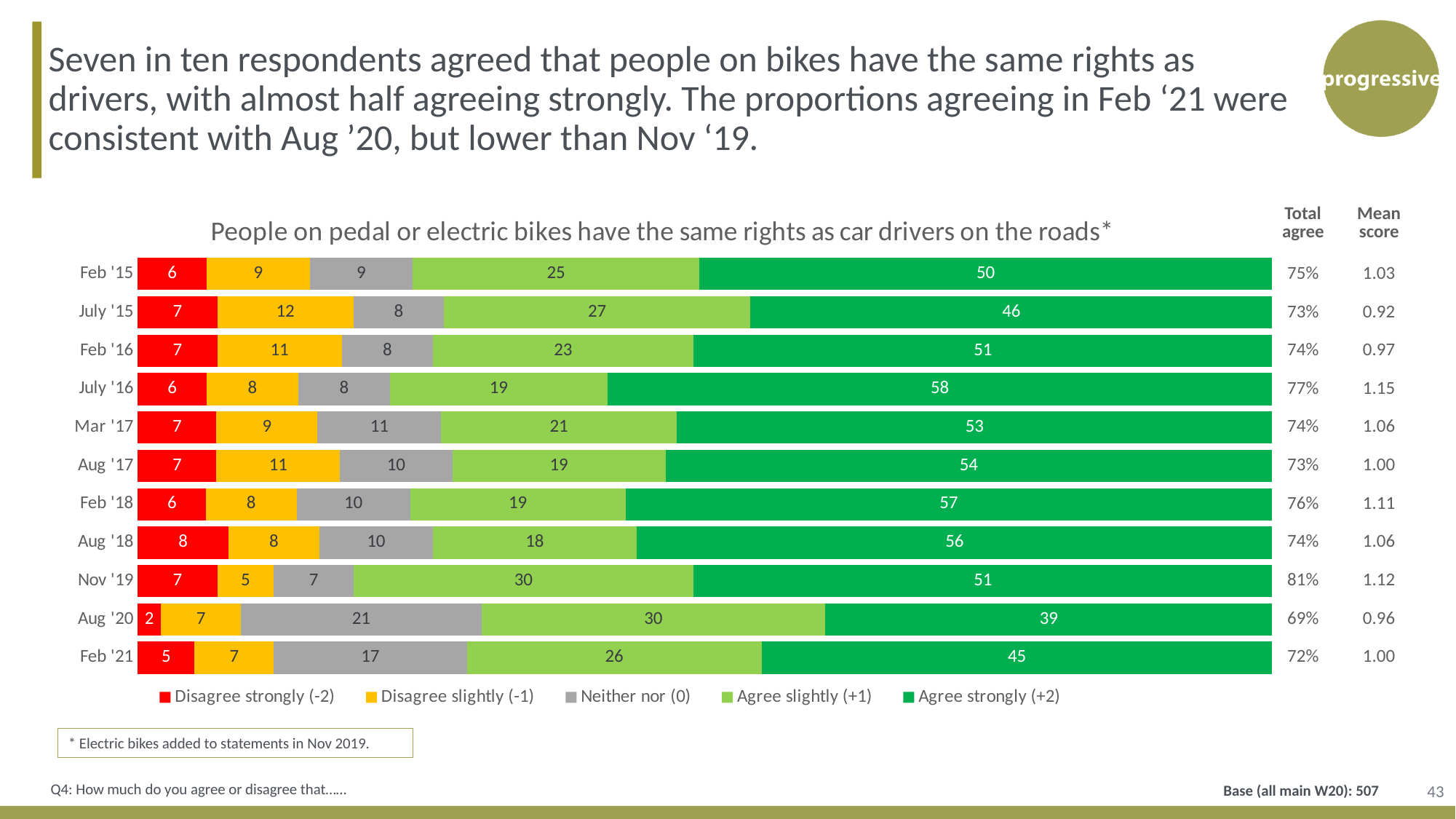
What is the title of the chart? People on pedal or electric bikes have the same rights as car drivers on the roads* What is the value for Neither nor (0) in Aug '20? 21 What is the value for Agree strongly (+2) in July '16? 58 What is the value for Disagree strongly (-2) in Aug '18? 8 What kind of chart is shown on the slide? Stacked bar chart How many waves (categories) are shown in the chart? 11 Which has the larger Neither nor (0) value, Aug '20 or Feb '21? Aug '20 Which wave has the highest value for Agree strongly (+2)? July '16 What is the total of the stacked bar for Feb '21? 100 Which wave has the lowest value for Agree strongly (+2)? Aug '20 How many series does the legend list? 5 What is the difference between the Agree slightly (+1) values for Nov '19 and Feb '15? 5